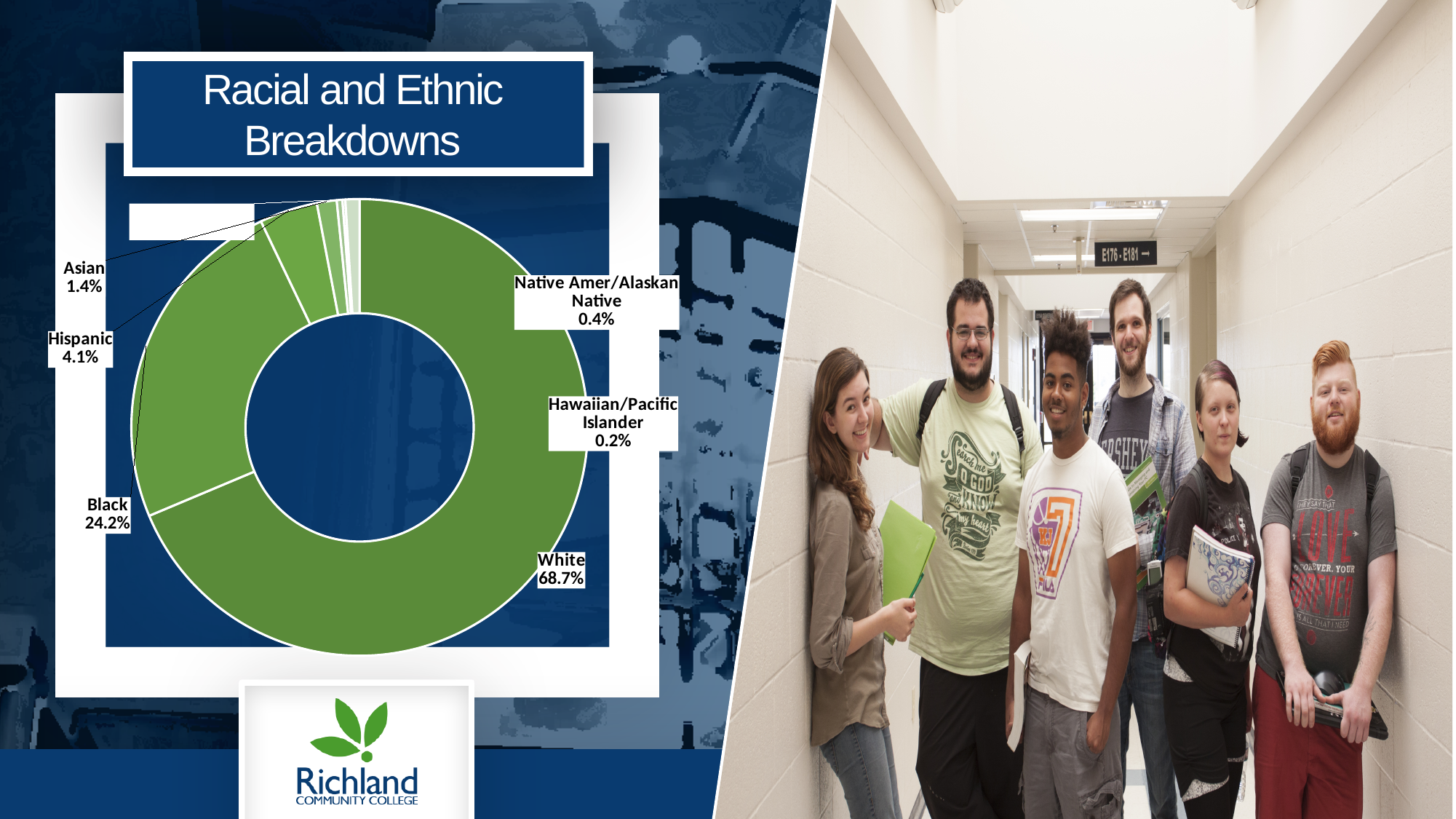
What percentage is shown for Asian? 1.4% What is the title of the chart? Racial and Ethnic Breakdowns Which is larger, the share for Hispanic or the share for Asian? Hispanic What percentage is shown for Native Amer/Alaskan Native? 0.4% What percentage is shown for Hawaiian/Pacific Islander? 0.2% What percentage is shown for White? 68.7% What is the difference in percentage points between White and Black? 44.5 What kind of chart is shown on the slide? Doughnut chart What percentage is shown for Black? 24.2% Which labeled category has the largest share of the chart? White What percentage is shown for Hispanic? 4.1% Which labeled category has the smallest share of the chart? Hawaiian/Pacific Islander